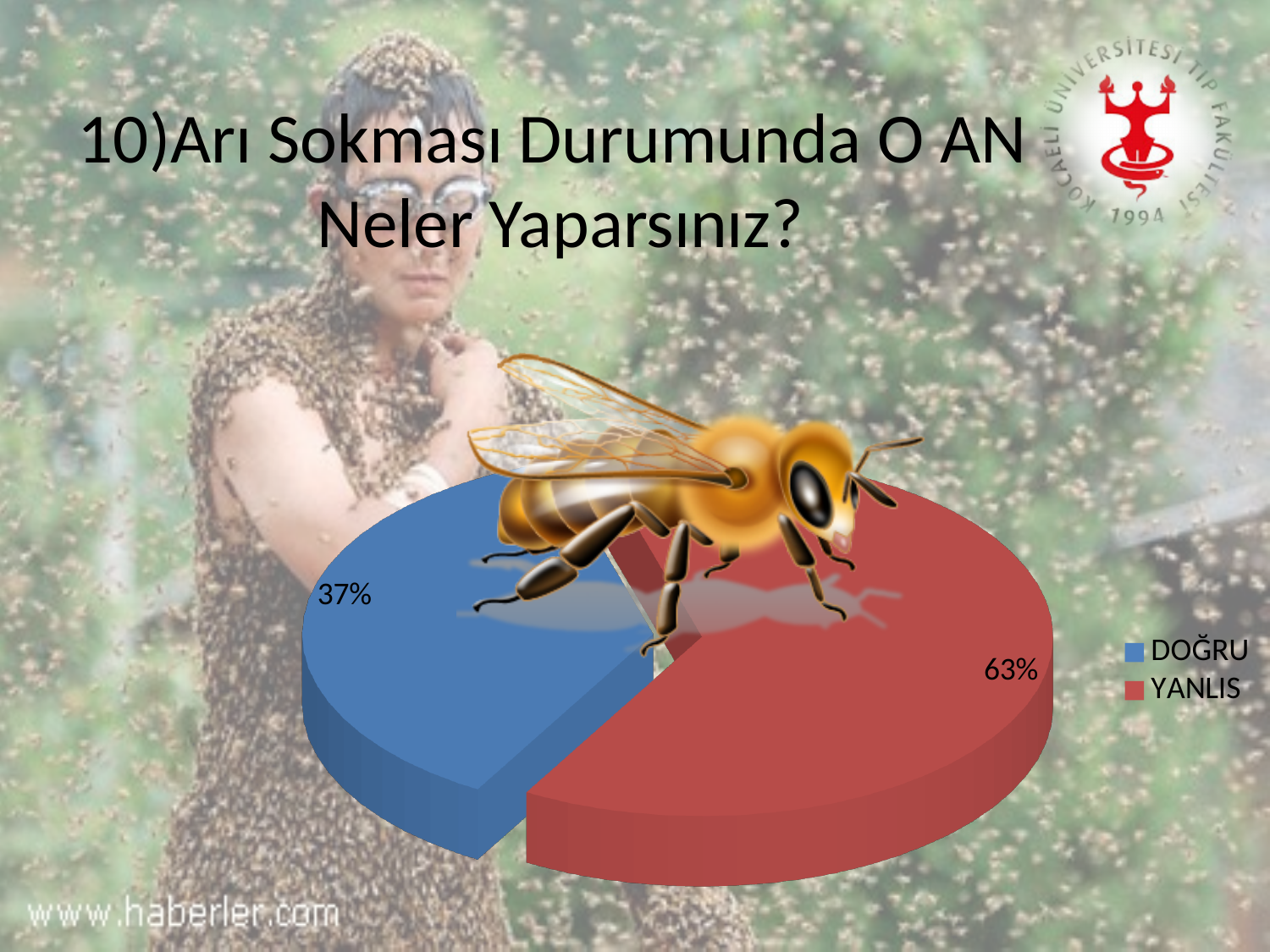
Which slice of the pie is the smallest? DOĞRU How many entries does the legend list? 2 Which is larger, the DOĞRU slice or the YANLIS slice? YANLIS Is the share of the DOĞRU slice greater or less than 50%? less How many slices does the pie chart have? 2 What percentage of the pie is labelled YANLIS? 63% What kind of chart is shown on the slide? pie chart What is the difference in percentage points between the YANLIS and DOĞRU slices? 26 What colour is the DOĞRU slice? blue What colour is the YANLIS slice? red Which slice of the pie is the largest? YANLIS What percentage of the pie is labelled DOĞRU? 37%